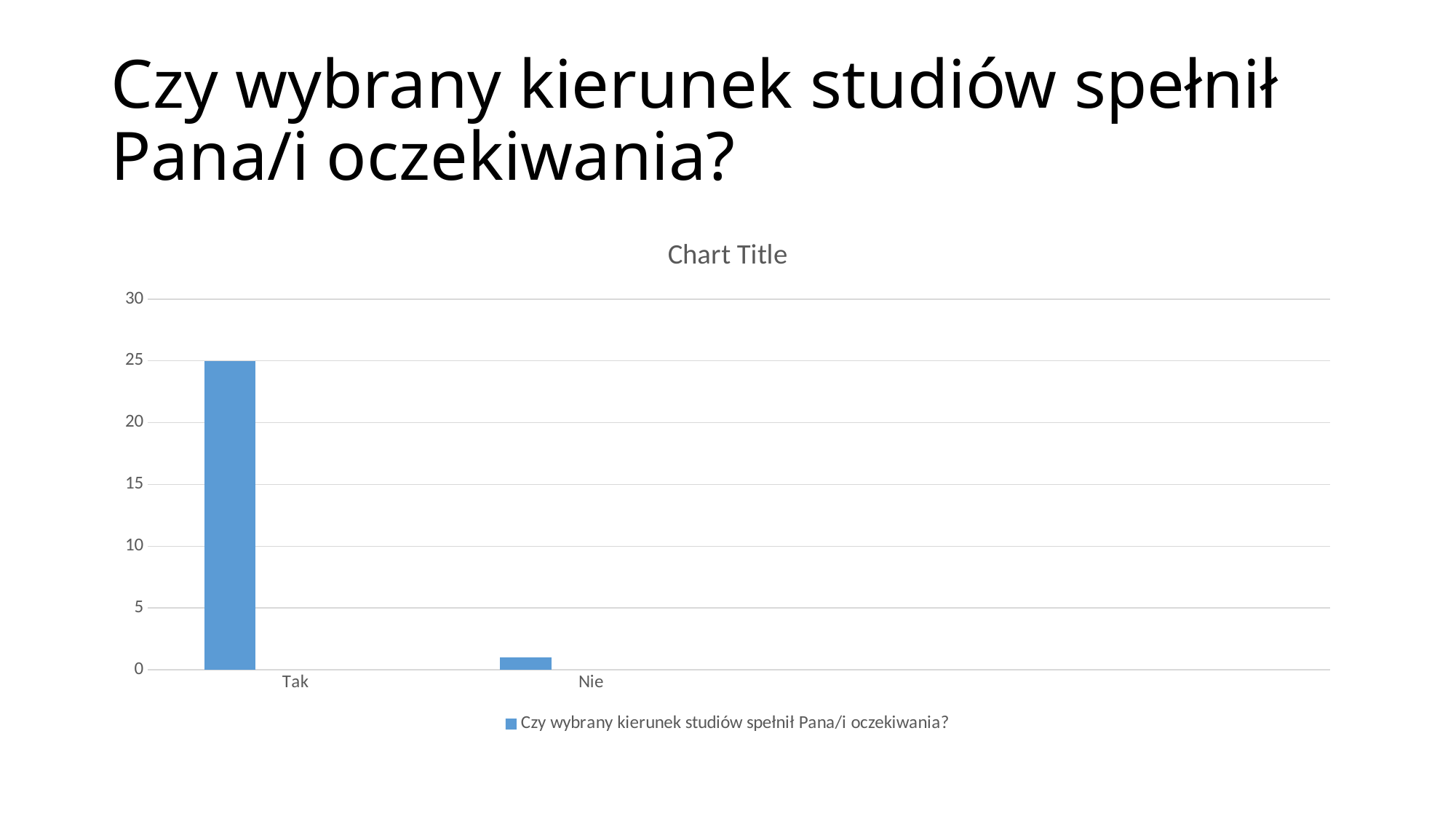
Is the value for Nie greater or less than 10? less What is the value for Tak in the chart? 25 How many series does the chart's legend list? 1 Is the value for Tak greater or less than 20? greater How many categories are shown on the x axis of the chart? 2 Which is larger, the value for Tak or the value for Nie? Tak What is the legend entry shown below the chart? Czy wybrany kierunek studiów spełnił Pana/i oczekiwania? Which category has the lowest value in the chart? Nie What is the title shown above the chart? Chart Title Is the value for Nie greater or less than 5? less What kind of chart is shown on the slide? bar chart Which category has the highest value in the chart? Tak